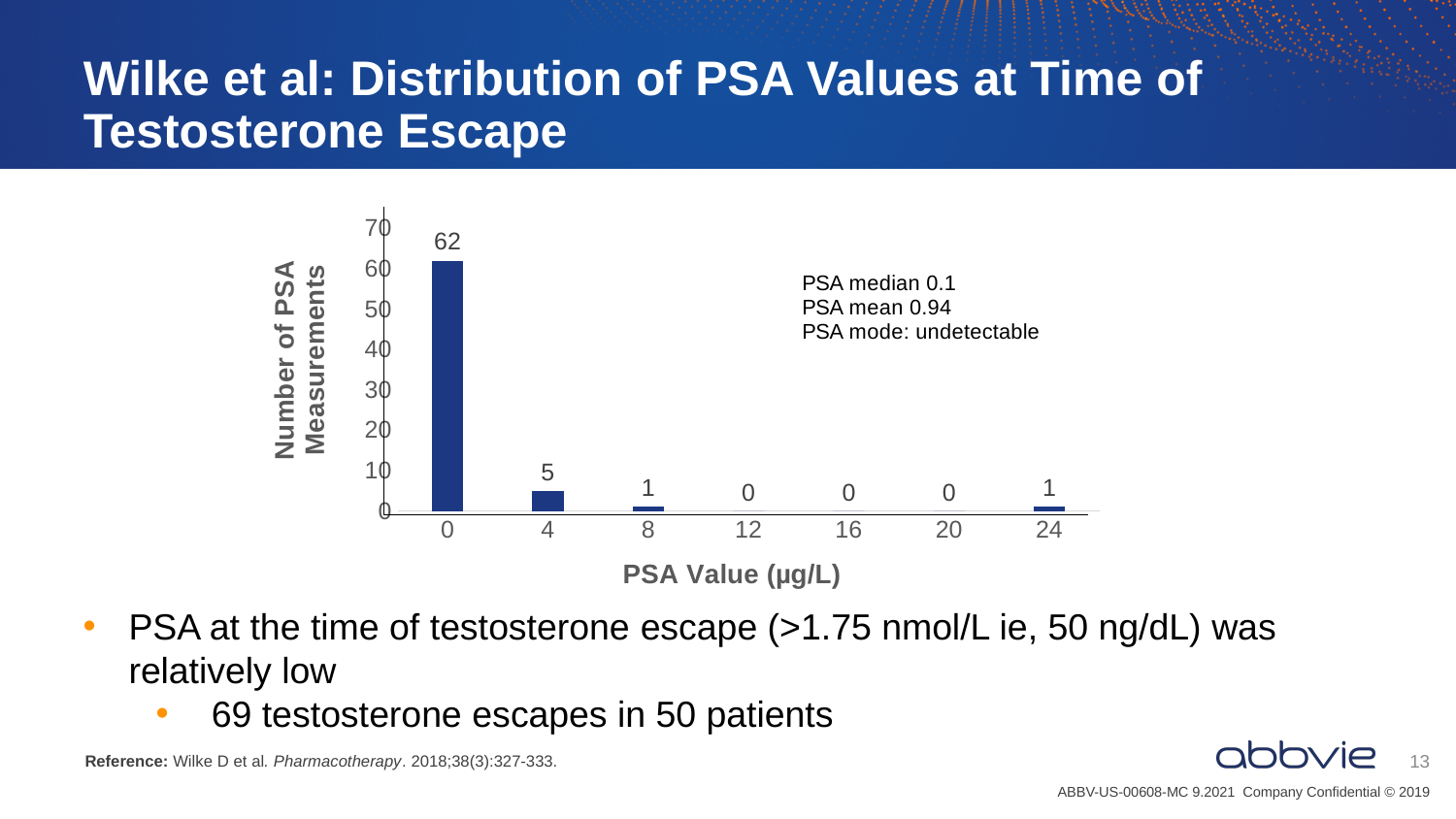
What is the number of PSA measurements for a PSA value of 24 µg/L? 1 How many PSA value categories are shown on the x axis? 7 What is the difference in number of measurements between the PSA value 0 and PSA value 4 categories? 57 What is the number of PSA measurements for a PSA value of 4 µg/L? 5 What kind of chart is shown on the slide? Bar chart Which has more measurements: PSA value 4 or PSA value 8? PSA value 4 Is the number of measurements for PSA value 0 greater or less than 60? greater How many PSA value categories have 0 measurements? 3 What is the label of the x axis of the chart? PSA Value (µg/L) Which PSA value category has the highest number of measurements? 0 What is the number of PSA measurements for a PSA value of 0 µg/L? 62 What PSA median is stated in the text annotation on the chart? 0.1